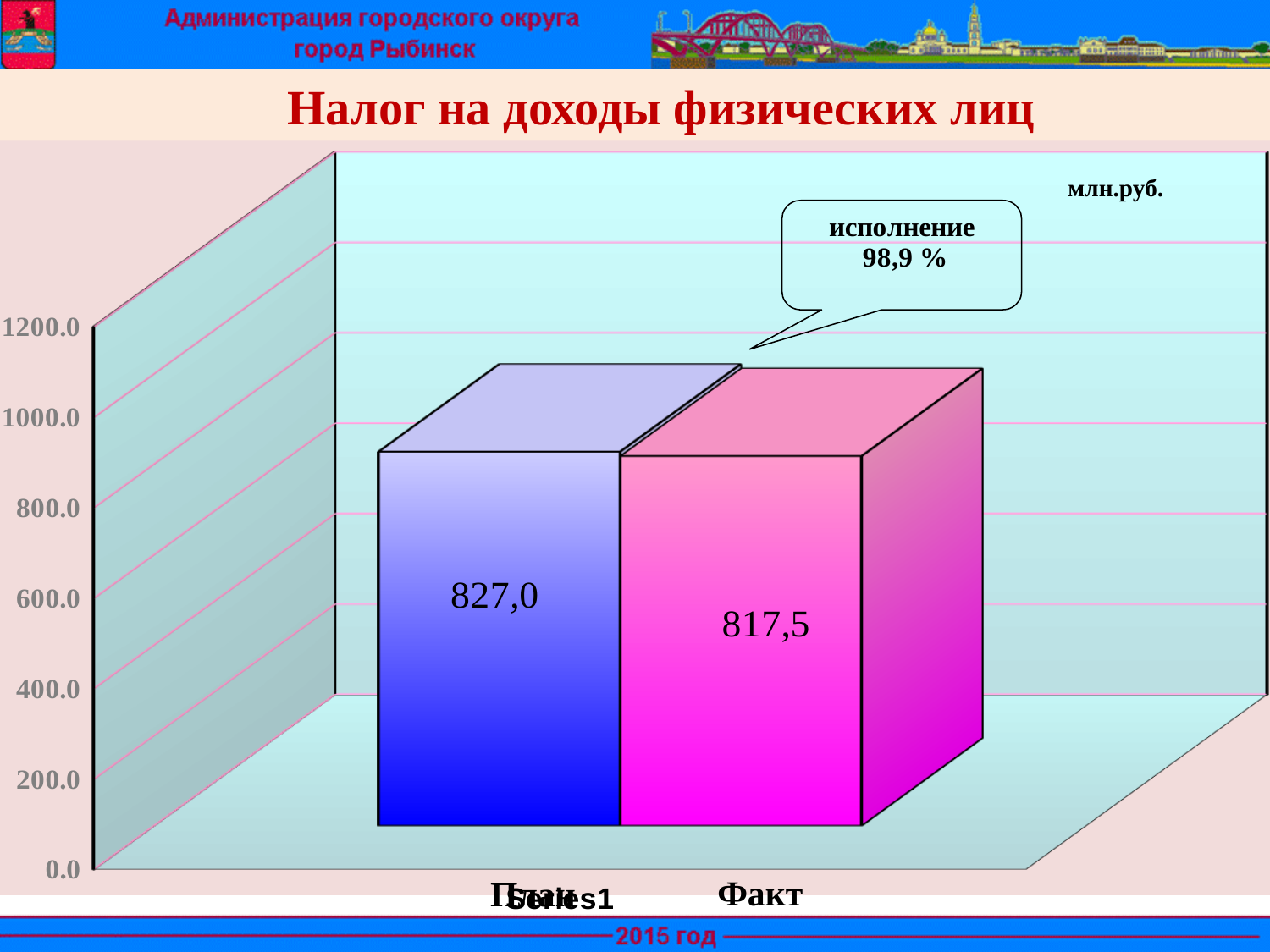
Which category has the lowest value? Факт How many bars are shown in the chart? 2 Is the value for Факт greater or less than 1000.0? less Which bar is higher, План or Факт? План Is the value for План greater or less than 800.0? greater What is the highest value shown on the vertical axis? 1200.0 What is the difference between the План and Факт values? 9,5 What execution percentage (исполнение) is shown in the callout? 98,9 % What is the value of the План bar? 827,0 What is the title of the chart? Налог на доходы физических лиц What type of chart is shown on the slide? bar chart What is the value of the Факт bar? 817,5